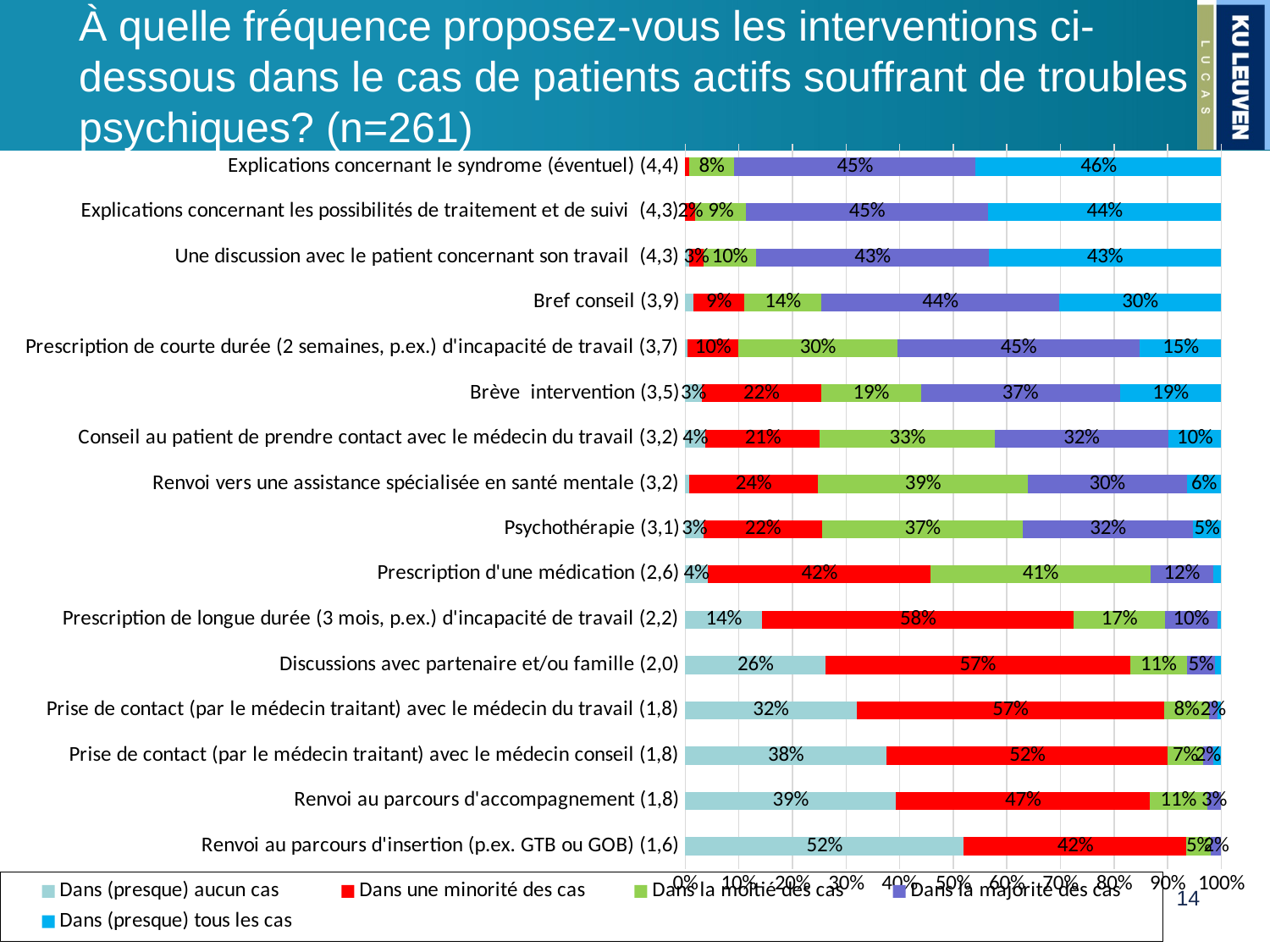
Which colour represents "Dans une minorité des cas" in the legend? Red How many intervention categories are shown on the chart? 16 What share of respondents chose "Dans (presque) aucun cas" for "Renvoi au parcours d'insertion (p.ex. GTB ou GOB)"? 52% What kind of chart is shown on the slide? Stacked bar chart For "Bref conseil", which is larger: the "Dans la majorité des cas" share or the "Dans (presque) tous les cas" share? Dans la majorité des cas How many series does the legend list? 5 What is the "Dans la moitié des cas" value for "Prescription d'une médication"? 41% What percentage of respondents answered "Dans (presque) tous les cas" for "Explications concernant le syndrome (éventuel)"? 46% What is the "Dans une minorité des cas" value for "Prescription de longue durée (3 mois, p.ex.) d'incapacité de travail"? 58% Which intervention has the highest "Dans (presque) aucun cas" share? Renvoi au parcours d'insertion (p.ex. GTB ou GOB) For "Prescription de courte durée (2 semaines, p.ex.) d'incapacité de travail", what is the difference between the "Dans la majorité des cas" share and the "Dans (presque) tous les cas" share? 30 percentage points What is the "Dans la majorité des cas" value for "Brève intervention"? 37%